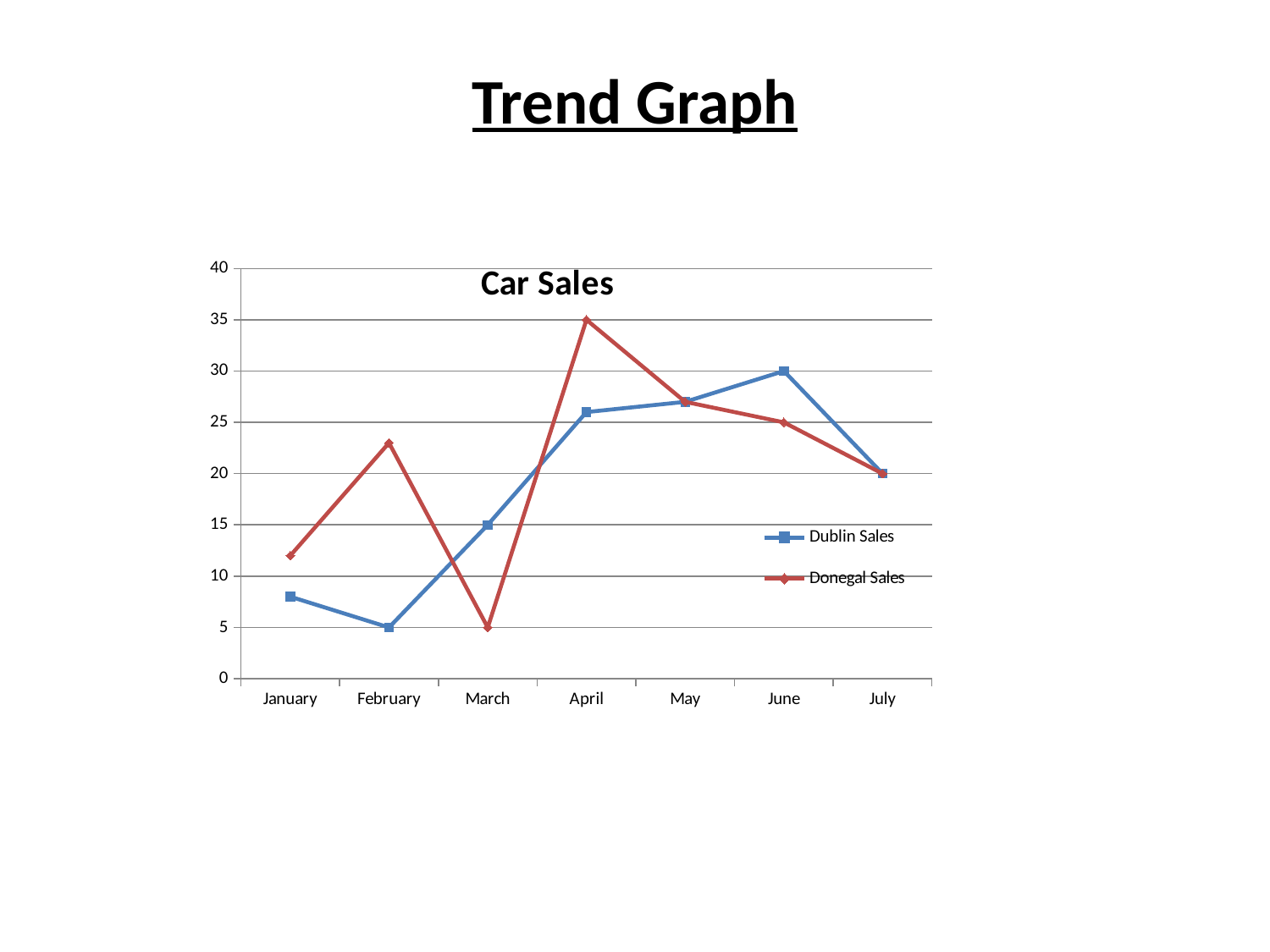
How many months are shown on the x axis of the Car Sales chart? 7 What is the Dublin Sales value for June? 30 What is the Dublin Sales value for February? 5 How many series does the legend of the Car Sales chart list? 2 What kind of chart is the Car Sales chart? line chart What is the difference between Dublin Sales in June and Dublin Sales in July? 10 Is the Donegal Sales value for January greater or less than 10? greater In which month is Donegal Sales highest? April Which series has the larger value in February, Dublin Sales or Donegal Sales? Donegal Sales In which month is Dublin Sales lowest? February What is the Donegal Sales value for March? 5 What is the Donegal Sales value for April? 35